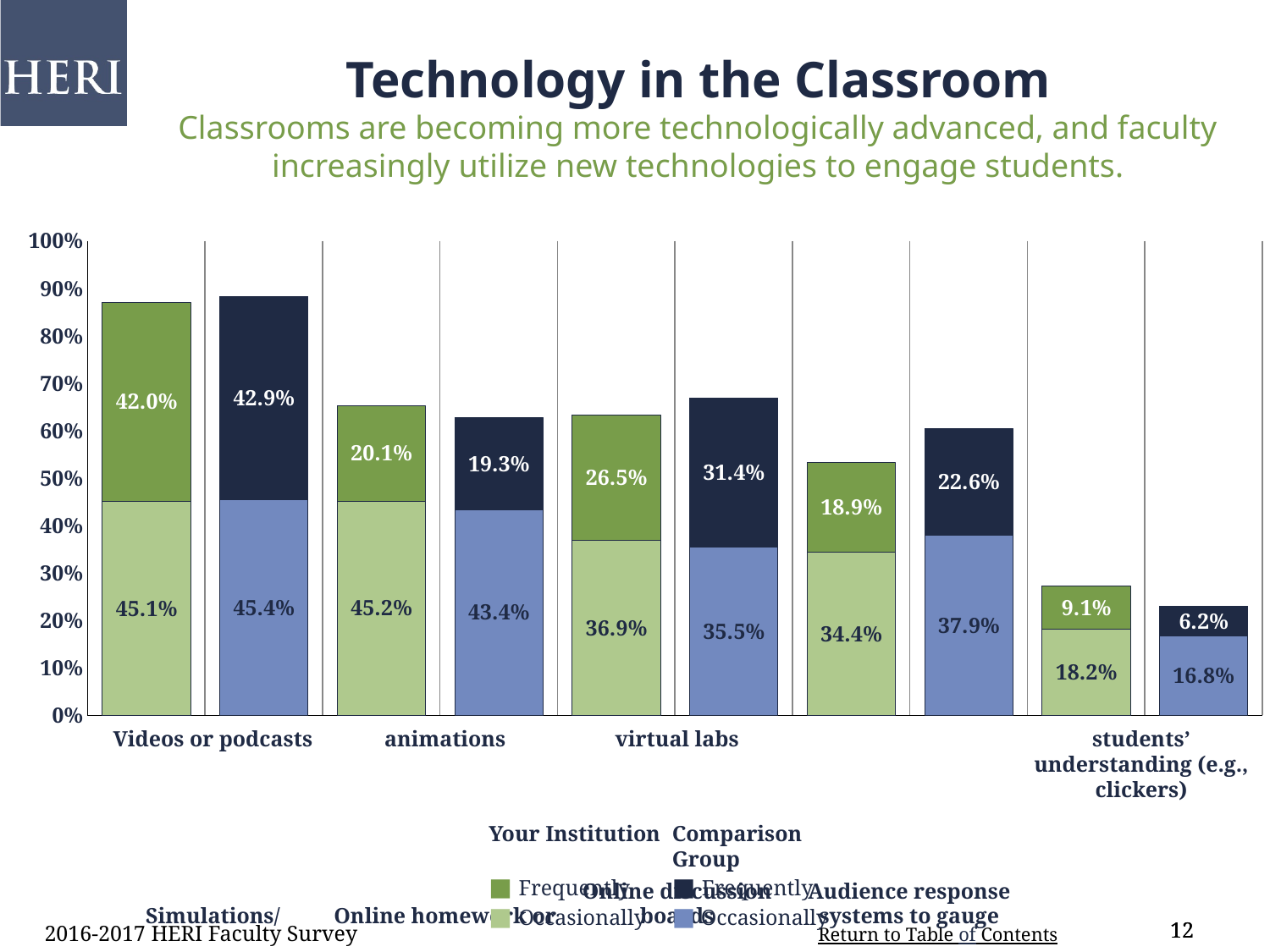
What kind of chart is shown on the slide? Stacked bar chart Which is larger for animations: the Your Institution 'Frequently' value or the Comparison Group 'Frequently' value? Your Institution (20.1%) What percentage of faculty at Your Institution report frequently using videos or podcasts? 42.0% Which category has the lowest Comparison Group 'Frequently' value? students' understanding (e.g., clickers) What is the difference between the Your Institution and Comparison Group 'Frequently' values for virtual labs? 4.9% Which category has the highest Your Institution 'Occasionally' value? animations What is the Comparison Group's 'Occasionally' value for virtual labs? 35.5% What is the total height of the Comparison Group stacked bar for students' understanding (e.g., clickers)? 23.0% What is the 'Frequently' value for Your Institution for students' understanding (e.g., clickers)? 9.1% What is the total height of the Your Institution stacked bar for videos or podcasts? 87.1% What is the Comparison Group's 'Occasionally' value for animations? 43.4% How many entries does the legend list? 4